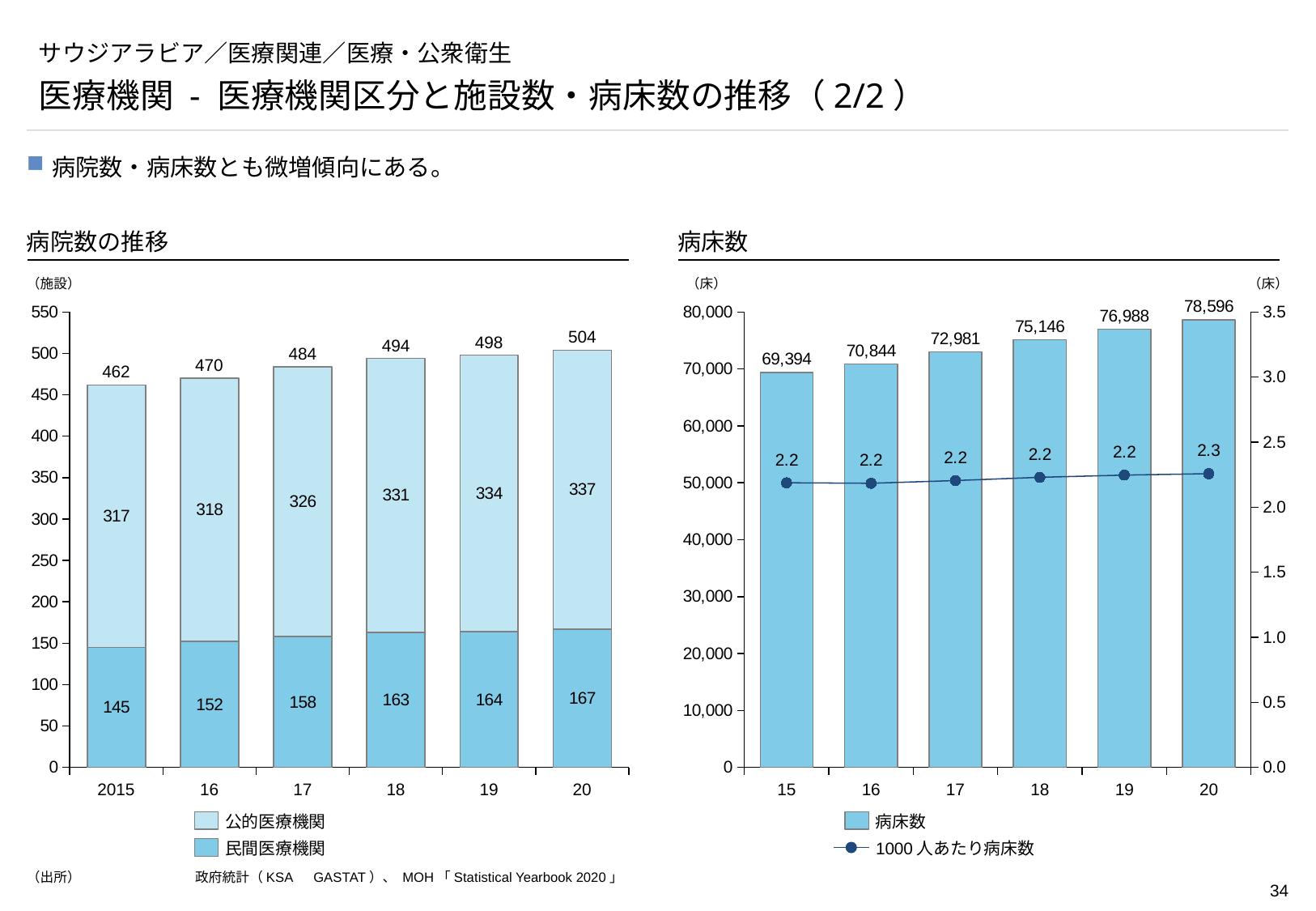
In the 病床数 chart, which year has the highest 病床数? 20 In the 病院数の推移 chart, what is the difference between the 公的医療機関 values for 20 and 2015? 20 In the 病院数の推移 chart, do the total values rise or fall from 2015 to 20? rise In the 病院数の推移 chart, how many series does the legend list? 2 In the 病院数の推移 chart, what is the value for 公的医療機関 in 20? 337 In the 病院数の推移 chart, what is the value for 民間医療機関 in 2015? 145 In the 病床数 chart, what is the value for 病床数 in 17? 72,981 In the 病床数 chart, what is the value for 1000人あたり病床数 in 20? 2.3 In the 病床数 chart, which year has the lowest 病床数? 15 In the 病床数 chart, how many years are shown on the x axis? 6 In the 病院数の推移 chart, what is the total of the stacked bar for 18? 494 In the 病床数 chart, what is the difference in 病床数 between 20 and 19? 1,608